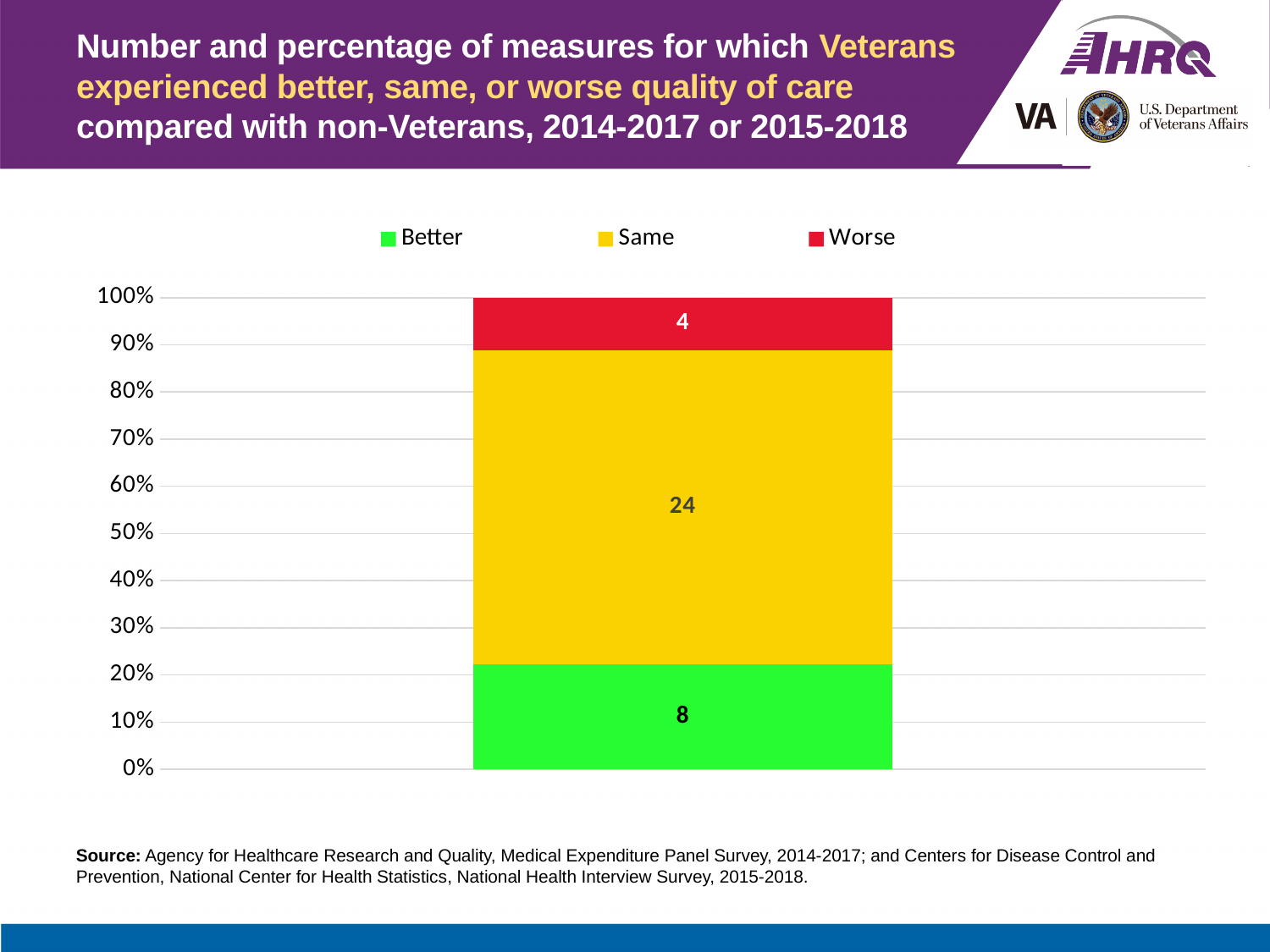
What is the total number of measures across all three segments of the stacked bar? 36 What colour represents the Worse series in the chart? Red Which series has the smallest number of measures? Worse Which series has the largest number of measures? Same What is the difference between the number of measures for Better and the number for Worse? 4 What kind of chart is shown on the slide? Stacked bar chart What is the difference between the number of measures for Same and the number for Better? 16 How many measures are labelled in the Worse segment of the stacked bar? 4 How many measures are labelled in the Better segment of the stacked bar? 8 Which is larger, the number of measures for Better or for Worse? Better How many measures are labelled in the Same segment of the stacked bar? 24 How many series does the legend list? 3